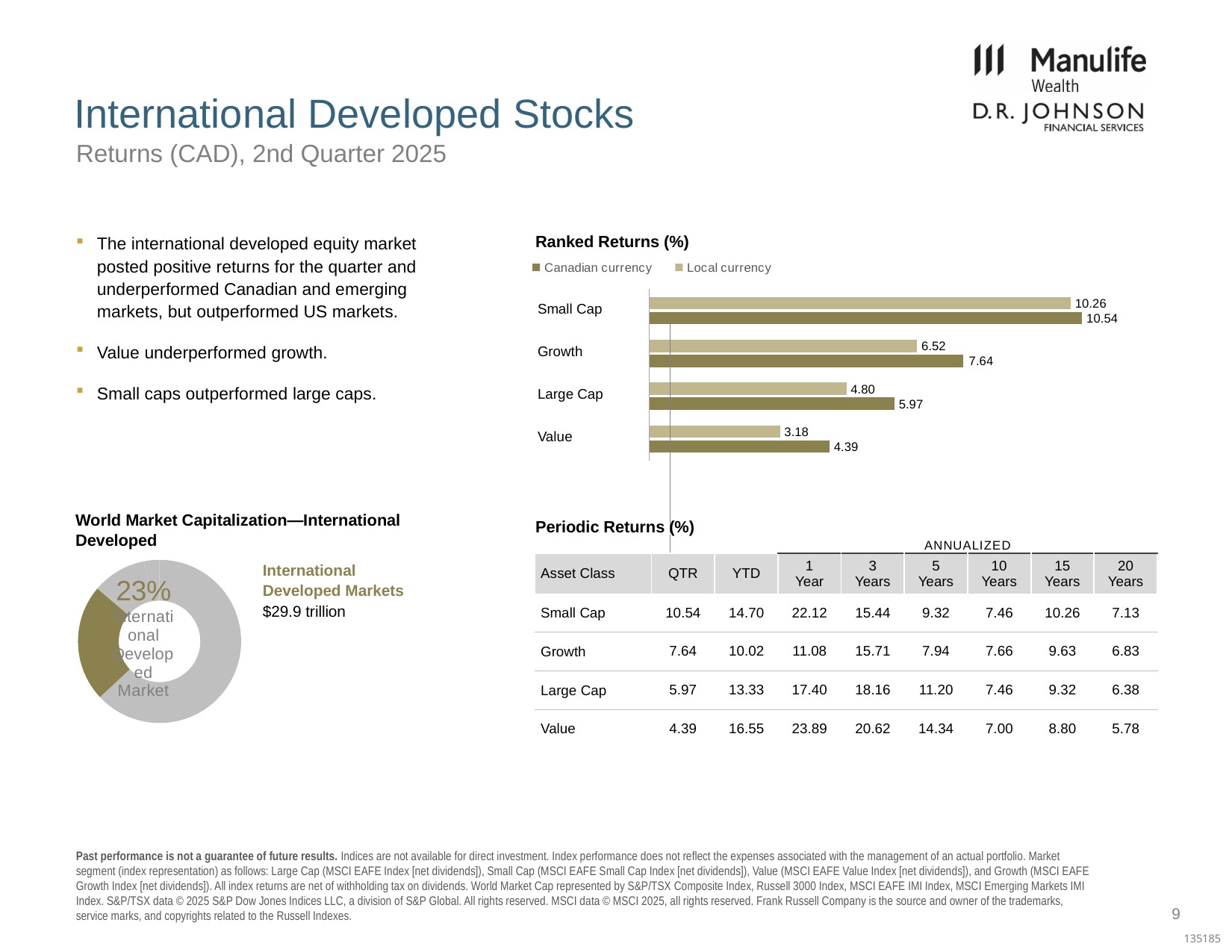
In the World Market Capitalization—International Developed chart, what share is shown for International Developed Market? 23% In the Ranked Returns (%) chart, what is the difference between the Canadian currency and Local currency values for Growth? 1.12 In the Ranked Returns (%) chart, which category has the lowest Local currency return? Value In the Ranked Returns (%) chart, which is larger for Large Cap: the Canadian currency value or the Local currency value? Canadian currency What kind of chart is the Ranked Returns (%) chart? Bar chart How many categories are shown in the Ranked Returns (%) chart? 4 In the Ranked Returns (%) chart, what is the Local currency value for Growth? 6.52 In the Ranked Returns (%) chart, what is the Canadian currency value for Small Cap? 10.54 In the Ranked Returns (%) chart, what is the Canadian currency value for Value? 4.39 How many series does the legend of the Ranked Returns (%) chart list? 2 In the Ranked Returns (%) chart, which category has the highest Canadian currency return? Small Cap In the Ranked Returns (%) chart, what is the Local currency value for Large Cap? 4.80